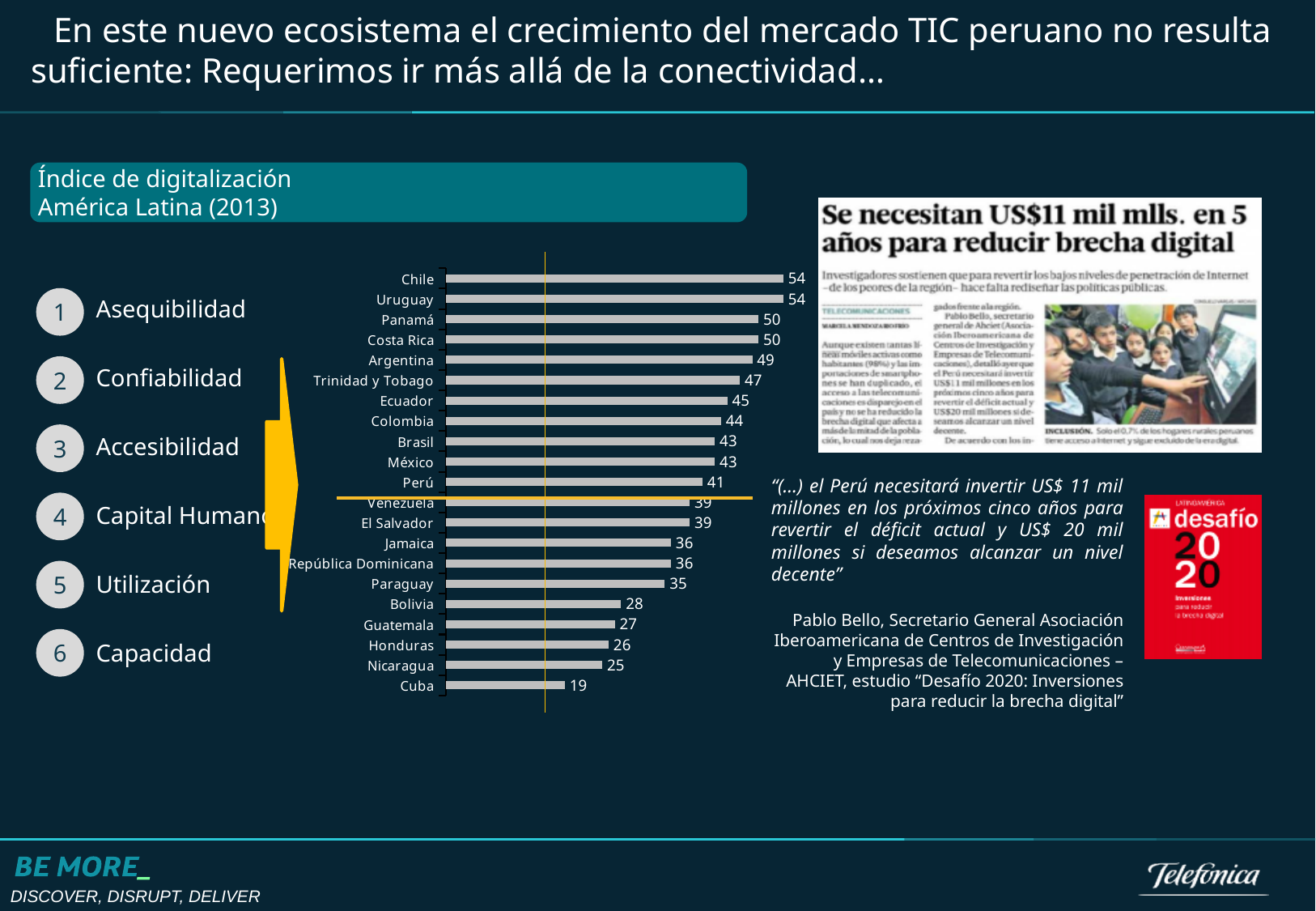
What type of chart is used to show the digitalization index? Bar chart Which has a higher digitalization index, Brasil or Guatemala? Brasil Which has a higher digitalization index, Ecuador or Paraguay? Ecuador What is the difference between the digitalization index of Chile and Perú? 13 What is the difference between the digitalization index of Colombia and Bolivia? 16 Which country has the lowest digitalization index in the chart? Cuba What is the title of the chart? Índice de digitalización América Latina (2013) Do the values decrease or increase going from the top of the chart (Chile) to the bottom (Cuba)? Decrease What is the digitalization index value for Perú? 41 What is the digitalization index value for Cuba? 19 What is the digitalization index value for Argentina? 49 How many countries are shown in the digitalization index chart? 21